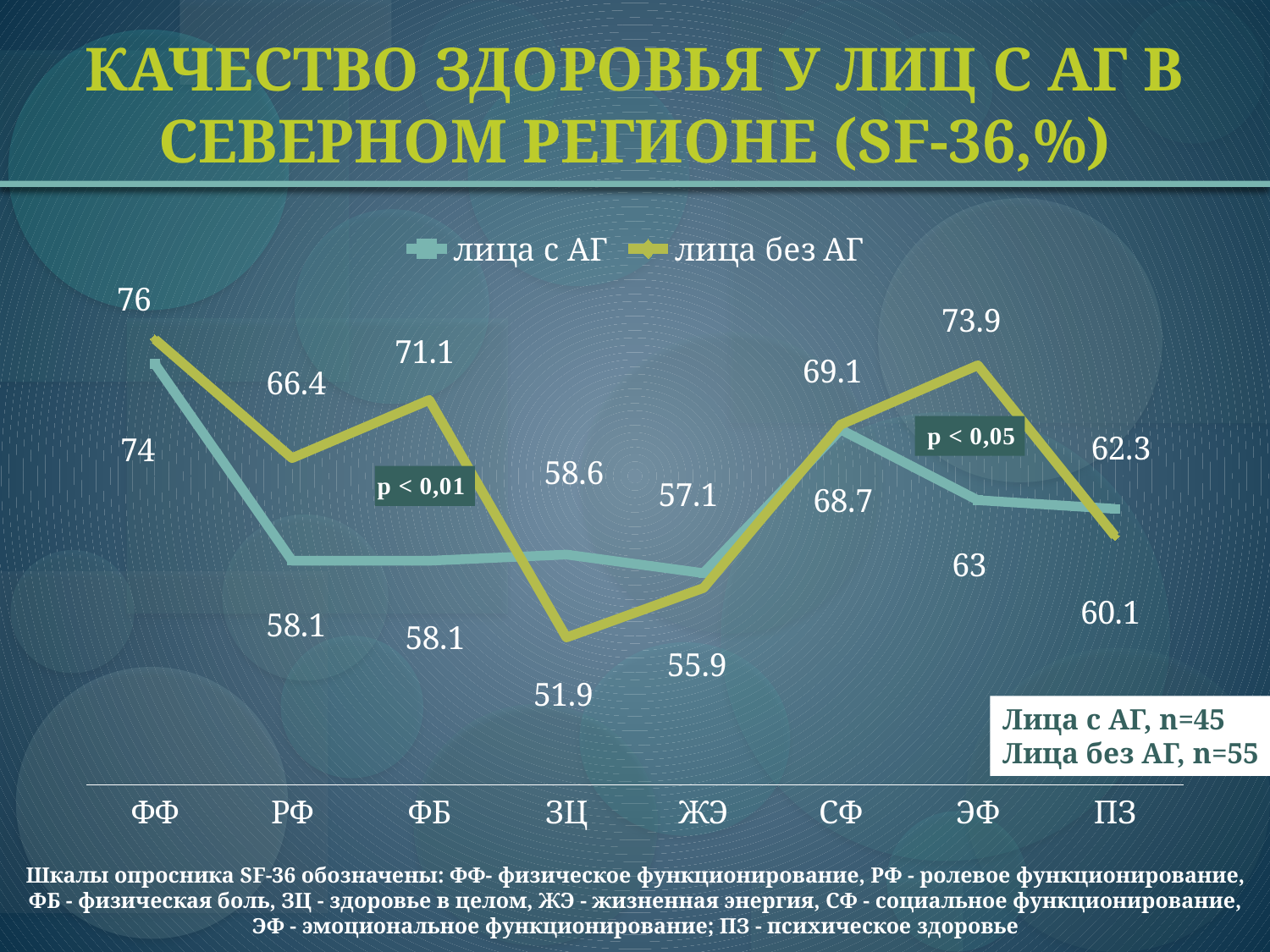
What kind of chart is shown on the slide? line chart What is the value for "лица с АГ" at ПЗ? 62.3 Which category has the highest value for "лица без АГ"? ФФ Which series has the larger value at ЗЦ, "лица с АГ" or "лица без АГ"? лица с АГ What is the difference between "лица без АГ" and "лица с АГ" at ФБ? 13 How many series does the legend list? 2 How many categories are shown on the x axis? 8 Which category has the lowest value for "лица без АГ"? ЗЦ What is the value for "лица с АГ" at ЭФ? 63 What is the value for "лица без АГ" at ЗЦ? 51.9 What are the two legend entries of the chart? лица с АГ; лица без АГ What is the value for "лица без АГ" at ФФ? 76